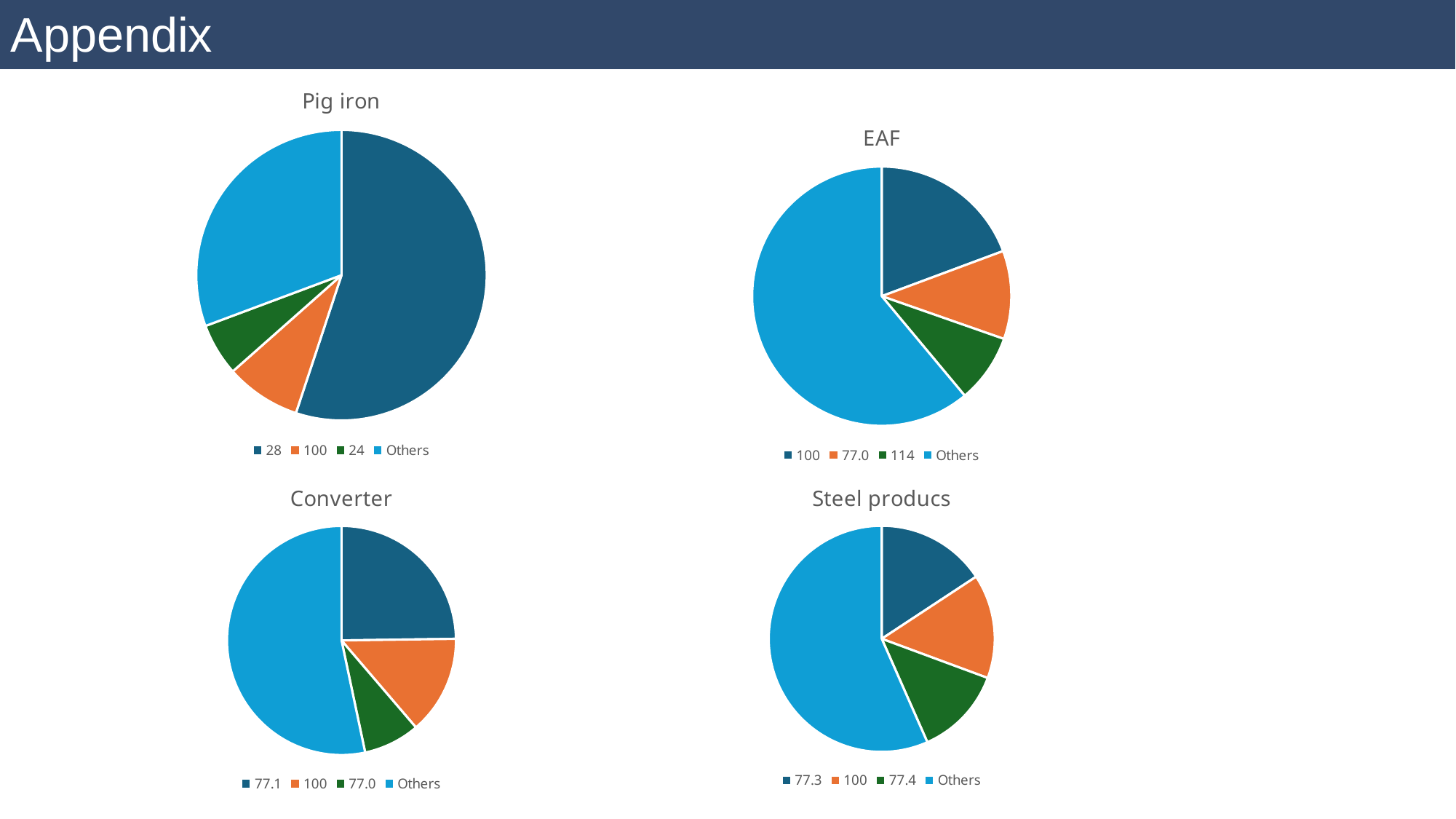
In the Pig iron chart, which legend entry has the smallest slice? 24 What kind of chart is the Pig iron chart? pie chart In the Converter chart, which legend entry has the smallest slice? 77.0 How many slices does the Pig iron pie chart have? 4 In the Converter chart, which legend entry has the largest slice? Others How many pie charts are shown on the slide? 4 In the Pig iron chart, which slice is larger: 28 or Others? 28 In the Steel producs chart, which legend entry has the largest slice? Others In the EAF chart, which legend entry has the smallest slice? 114 In the Pig iron chart, which legend entry has the largest slice? 28 In the EAF chart, which slice is larger: 100 or 114? 100